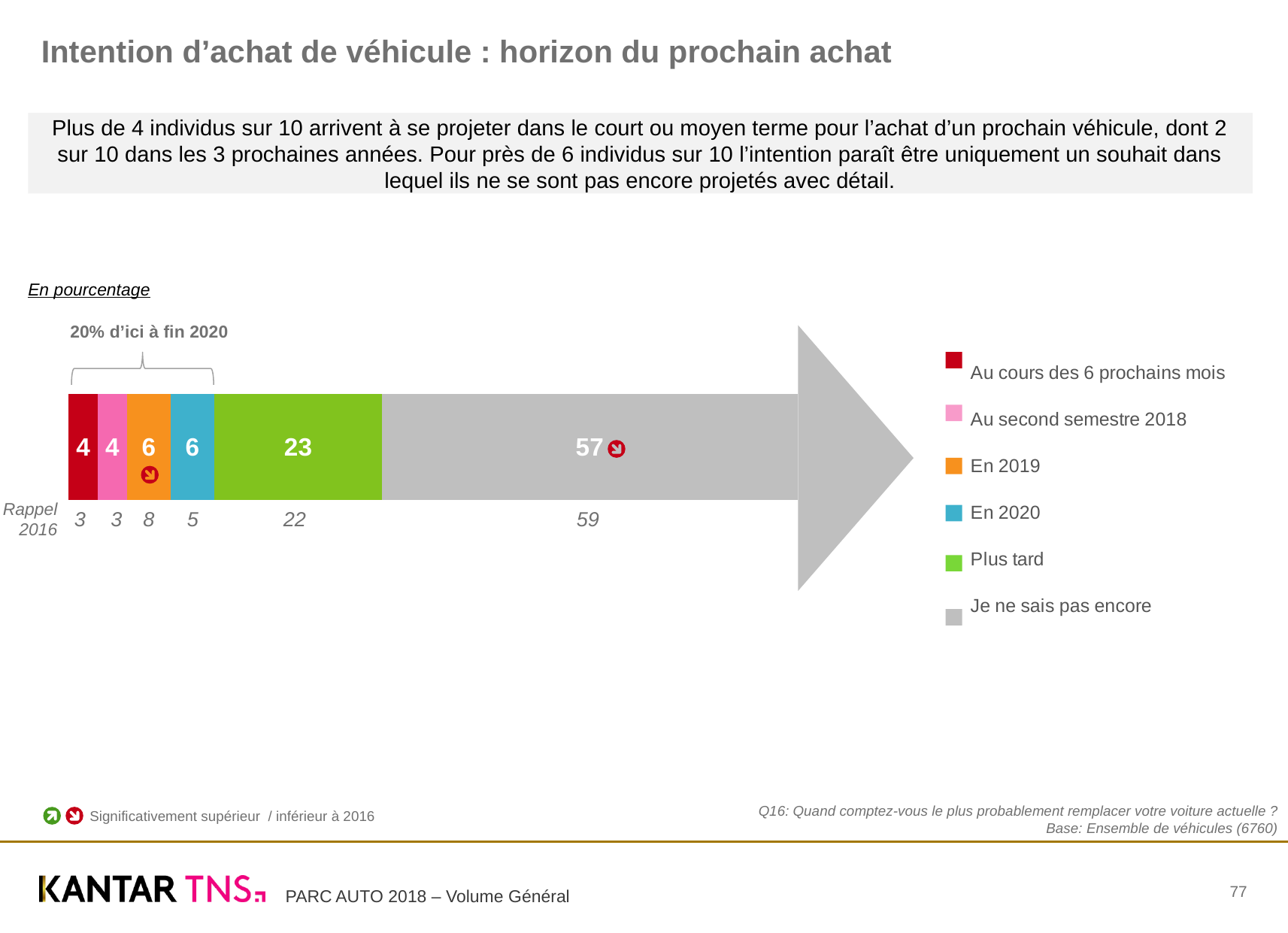
What kind of chart is shown on the slide? Stacked bar chart How many segments make up the stacked bar? 6 What was the "Rappel 2016" value for "Je ne sais pas encore"? 59 What share of respondents does the bracket above the first four segments indicate for purchases by end of 2020? 20% What was the "Rappel 2016" value for "En 2019"? 8 Which category has the highest value in the stacked bar? Je ne sais pas encore What is the difference between the "Je ne sais pas encore" value and the "Plus tard" value in the stacked bar? 34 How many entries does the legend list? 6 What is the value for "En 2019" in the stacked bar? 6 Which is larger in the stacked bar: the value for "En 2020" or the value for "Au second semestre 2018"? En 2020 What is the value for "Je ne sais pas encore" in the stacked bar? 57 What is the value for "Plus tard" in the stacked bar? 23